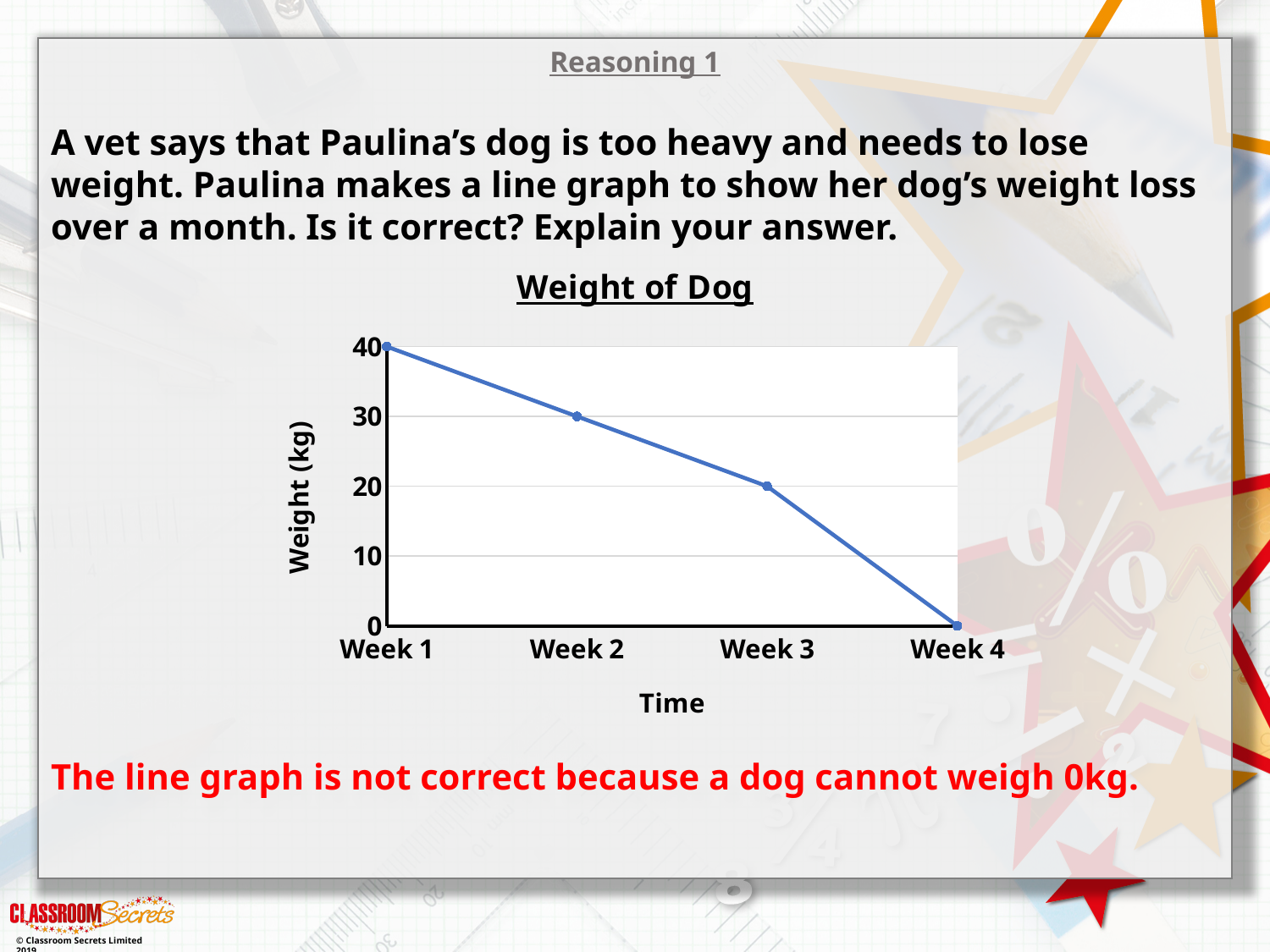
What is the dog's weight in Week 4? 0 kg Does the dog's weight rise or fall from Week 1 to Week 4? fall What is the dog's weight in Week 2? 30 kg What kind of chart is shown on the slide? line chart What is the dog's weight in Week 3? 20 kg Which is larger, the weight in Week 2 or the weight in Week 4? Week 2 In which week is the dog's weight highest? Week 1 What is the dog's weight in Week 1? 40 kg What is the difference in weight between Week 1 and Week 3? 20 kg In which week is the dog's weight lowest? Week 4 How many weeks are plotted on the x axis? 4 What is the title of the chart? Weight of Dog